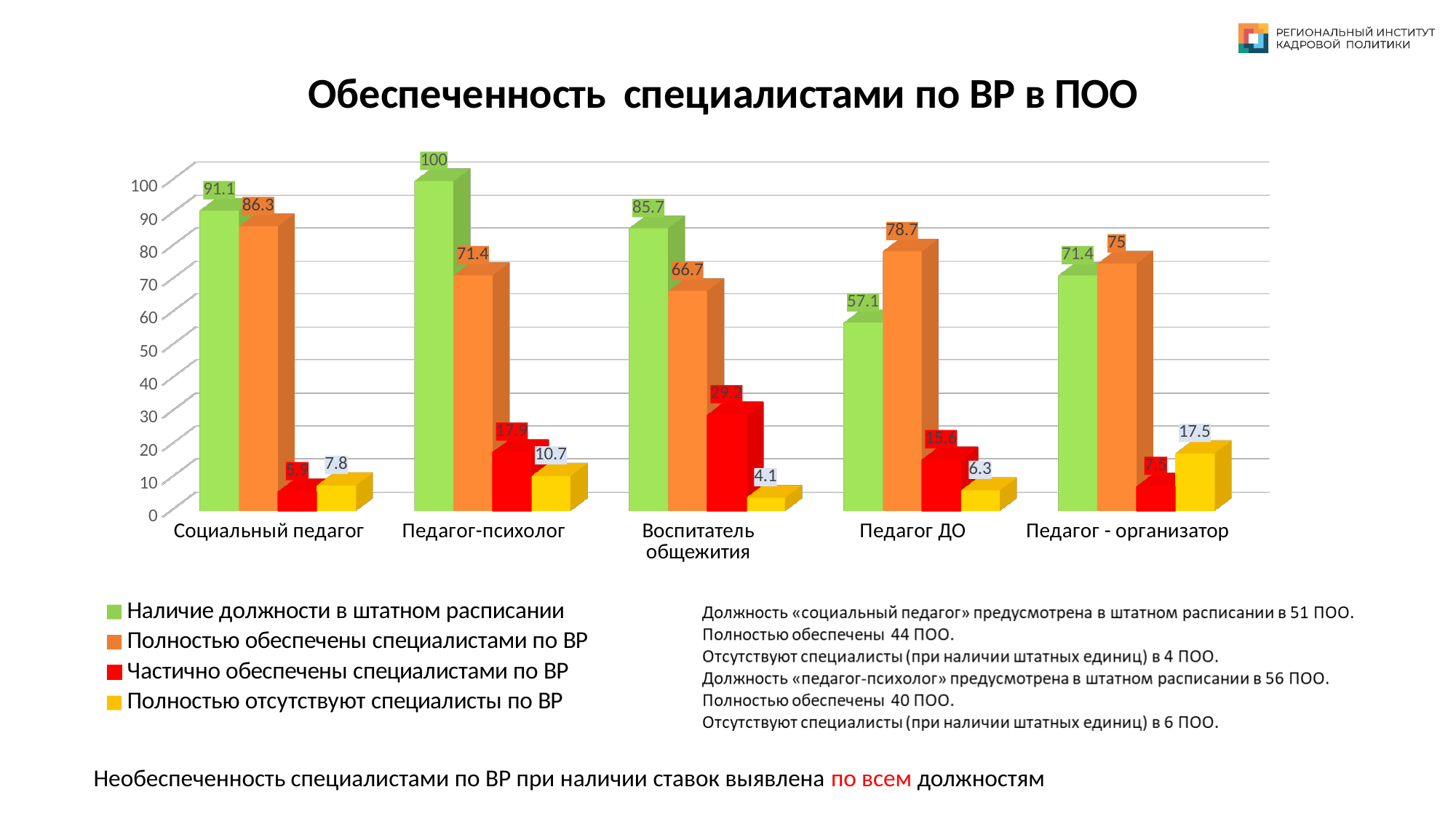
What is the value of 'Полностью отсутствуют специалисты по ВР' for 'Педагог - организатор'? 17.5 What type of chart is shown on the slide? Bar chart Which category has the lowest value for 'Полностью отсутствуют специалисты по ВР'? Воспитатель общежития Which category has the highest value for 'Наличие должности в штатном расписании'? Педагог-психолог What is the value of 'Полностью обеспечены специалистами по ВР' for 'Педагог ДО'? 78.7 For 'Педагог ДО', which is larger: 'Наличие должности в штатном расписании' or 'Полностью обеспечены специалистами по ВР'? Полностью обеспечены специалистами по ВР What is the title of the slide's chart? Обеспеченность специалистами по ВР в ПОО What is the value of 'Частично обеспечены специалистами по ВР' for 'Воспитатель общежития'? 29.2 What is the difference between 'Наличие должности в штатном расписании' and 'Полностью обеспечены специалистами по ВР' for 'Социальный педагог'? 4.8 What is the value of 'Наличие должности в штатном расписании' for 'Педагог-психолог'? 100 How many categories are shown on the x axis of the chart? 5 How many series does the chart legend list? 4